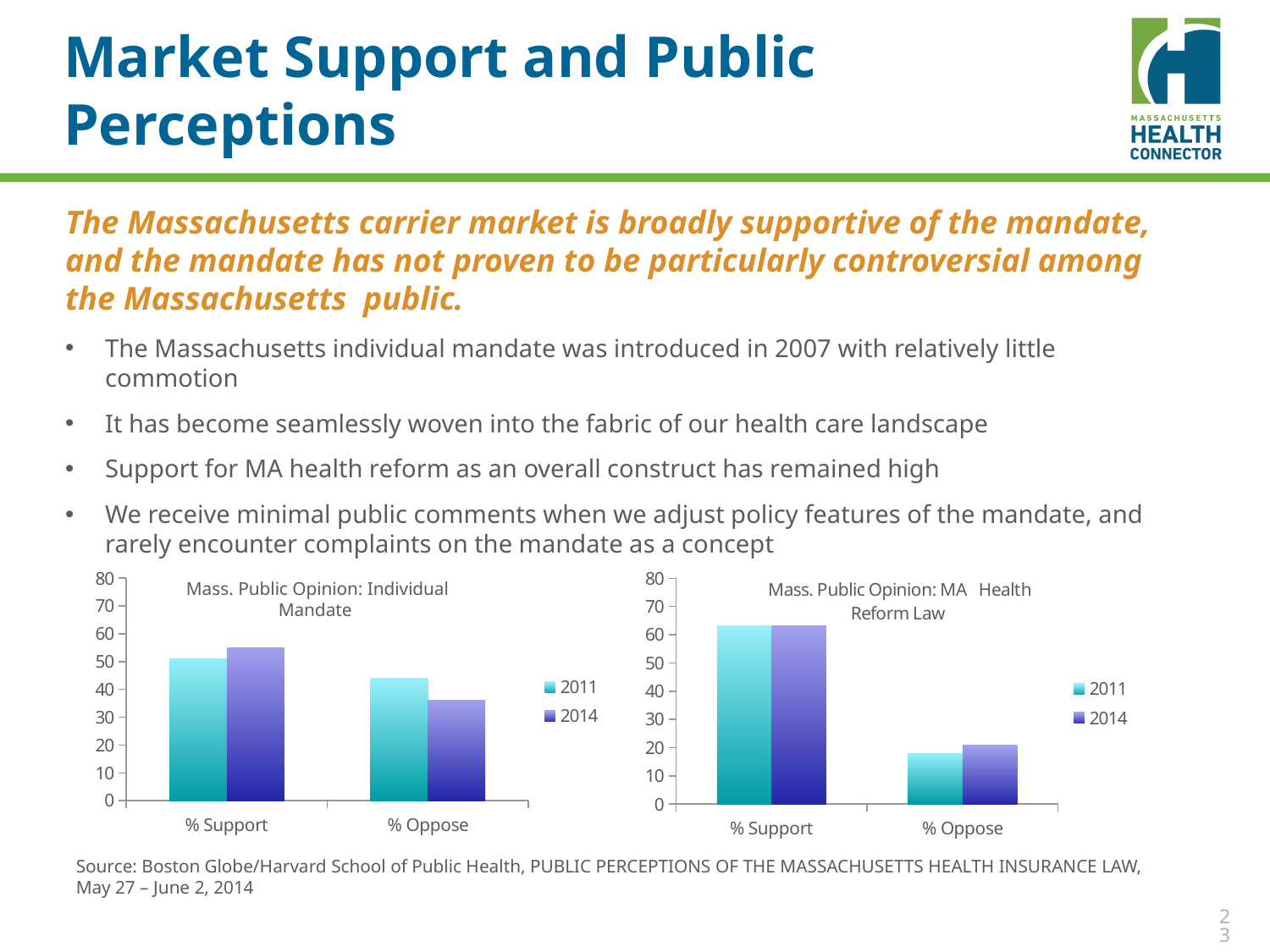
In the 'Mass. Public Opinion: Individual Mandate' chart, which year has the larger value for % Oppose, 2011 or 2014? 2011 In the 'Mass. Public Opinion: Individual Mandate' chart, is the 2011 value for % Oppose greater or less than 40? greater In the 'Mass. Public Opinion: MA Health Reform Law' chart, is the 2011 value for % Oppose greater or less than 20? less In the 'Mass. Public Opinion: MA Health Reform Law' chart, which category has the lowest bars? % Oppose What are the two legend entries in the 'Mass. Public Opinion: MA Health Reform Law' chart? 2011 and 2014 In the 'Mass. Public Opinion: Individual Mandate' chart, is the 2014 value for % Oppose greater or less than 40? less How many series does the legend of the 'Mass. Public Opinion: MA Health Reform Law' chart list? 2 How many categories are shown on the x axis of the 'Mass. Public Opinion: Individual Mandate' chart? 2 What kind of chart is the 'Mass. Public Opinion: Individual Mandate' chart? bar chart In the 'Mass. Public Opinion: Individual Mandate' chart, which year has the larger value for % Support, 2011 or 2014? 2014